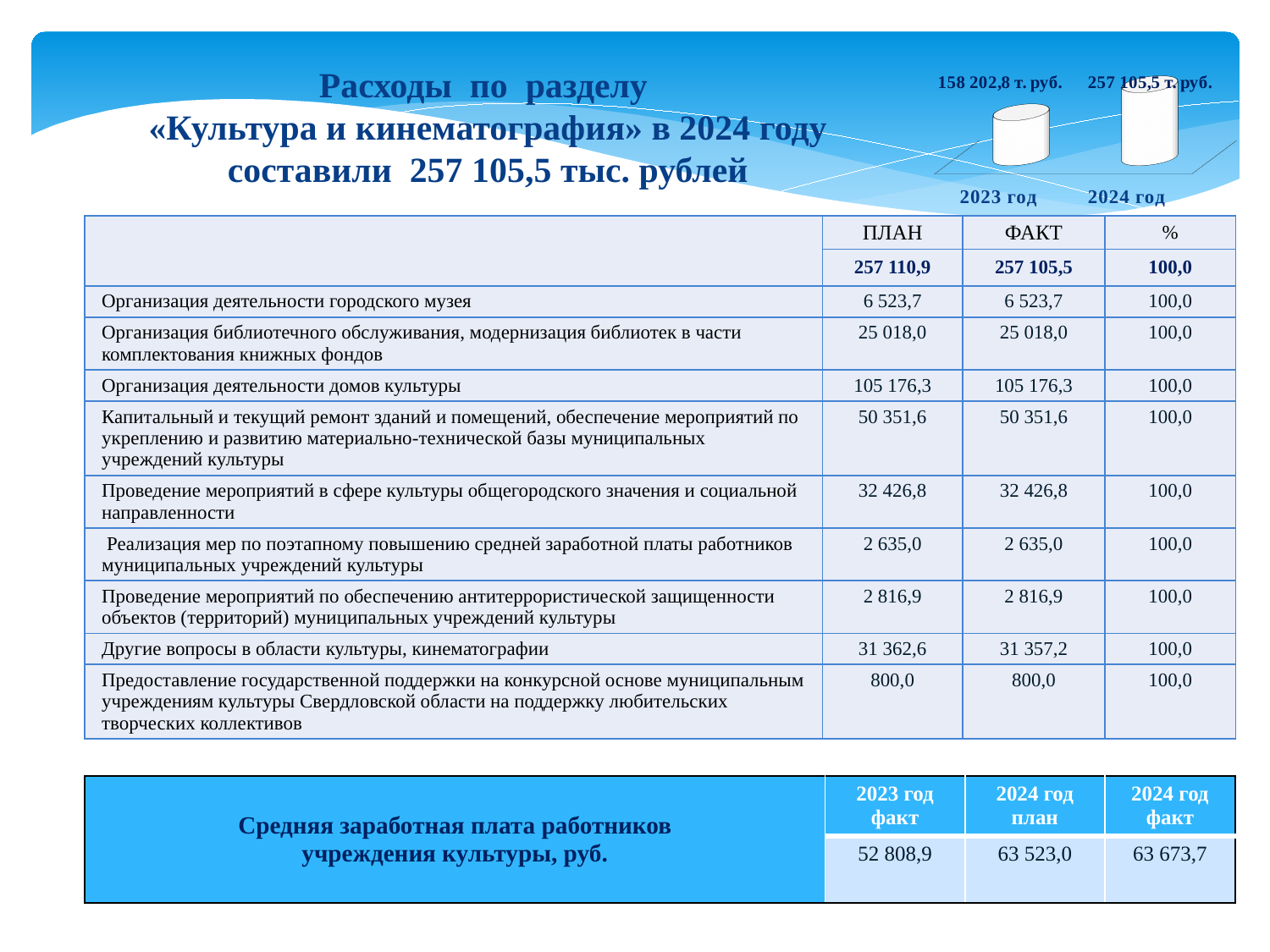
How many bars are plotted in the chart at the top right of the slide? 2 What kind of chart is shown at the top right of the slide? bar chart What are the two category labels shown under the bars in the chart at the top right of the slide? 2023 год and 2024 год In the chart at the top right of the slide, what is the value shown for 2023 год? 158 202,8 т. руб. In the chart at the top right of the slide, is the value for 2024 год larger or smaller than the value for 2023 год? larger In the chart at the top right of the slide, what is the value shown for 2024 год? 257 105,5 т. руб. In the chart at the top right of the slide, by how much does the 2024 год value exceed the 2023 год value? 98 902,7 т. руб. In the chart at the top right of the slide, do the values rise or fall from 2023 год to 2024 год? rise In the chart at the top right of the slide, which year has the lower value? 2023 год In the chart at the top right of the slide, which year has the higher value? 2024 год